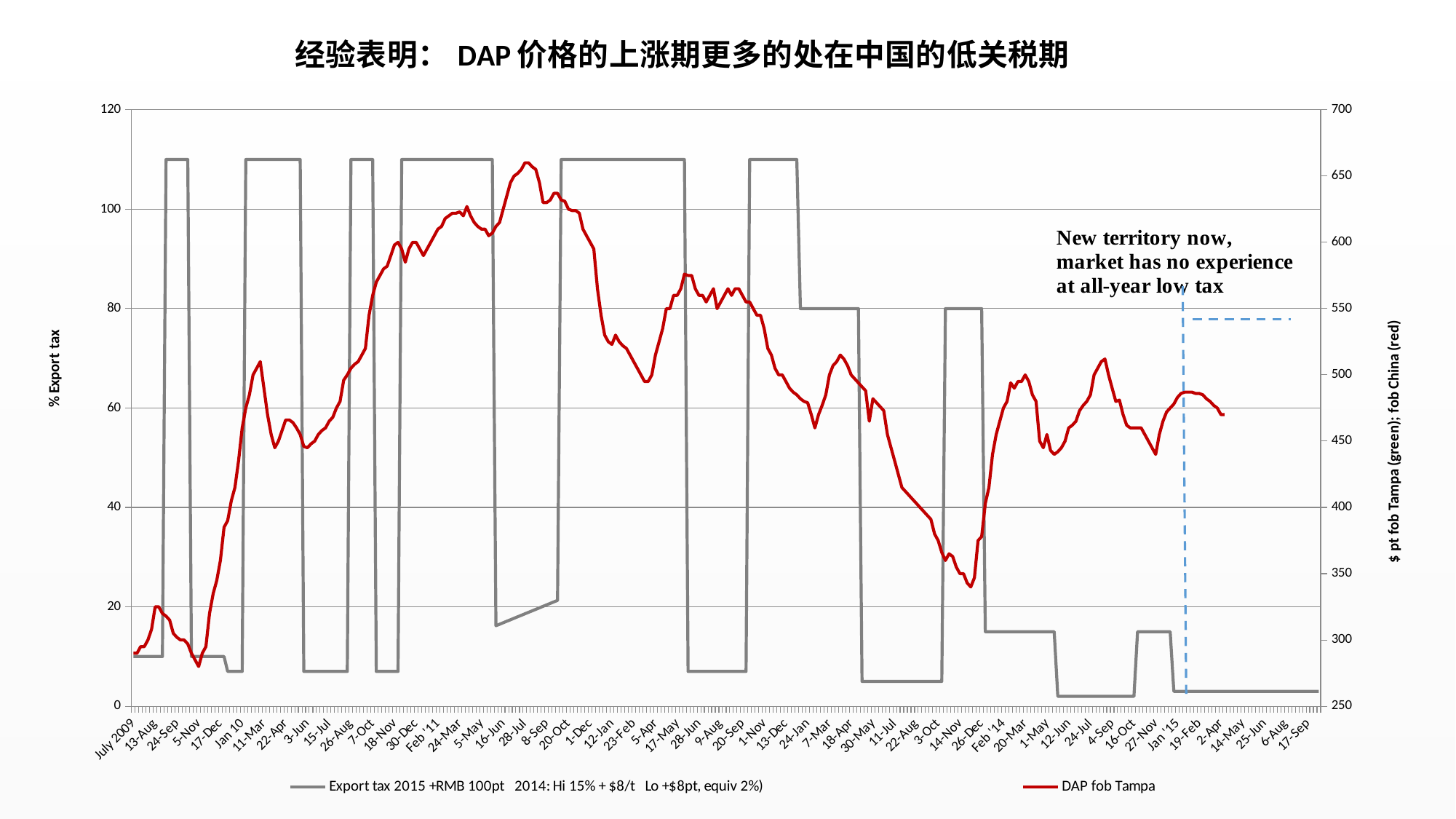
Does the DAP fob Tampa series rise or fall overall from 28-Jul 2011 to 26-Nov 2013? fall How many series does the legend list? 2 Is the DAP fob Tampa value at 5-Nov (2009) greater or less than 300? less What is the title of the left vertical axis? % Export tax Is the DAP fob Tampa value at 26-Nov (2013) greater or less than 400? less Is the value of the Export tax series at 24-Sep (2009) greater or less than 100? greater What kind of chart is shown on the slide? line chart Does the DAP fob Tampa series rise or fall overall from July 2009 to 28-Jul 2011? rise What is the label of the red series in the legend? DAP fob Tampa